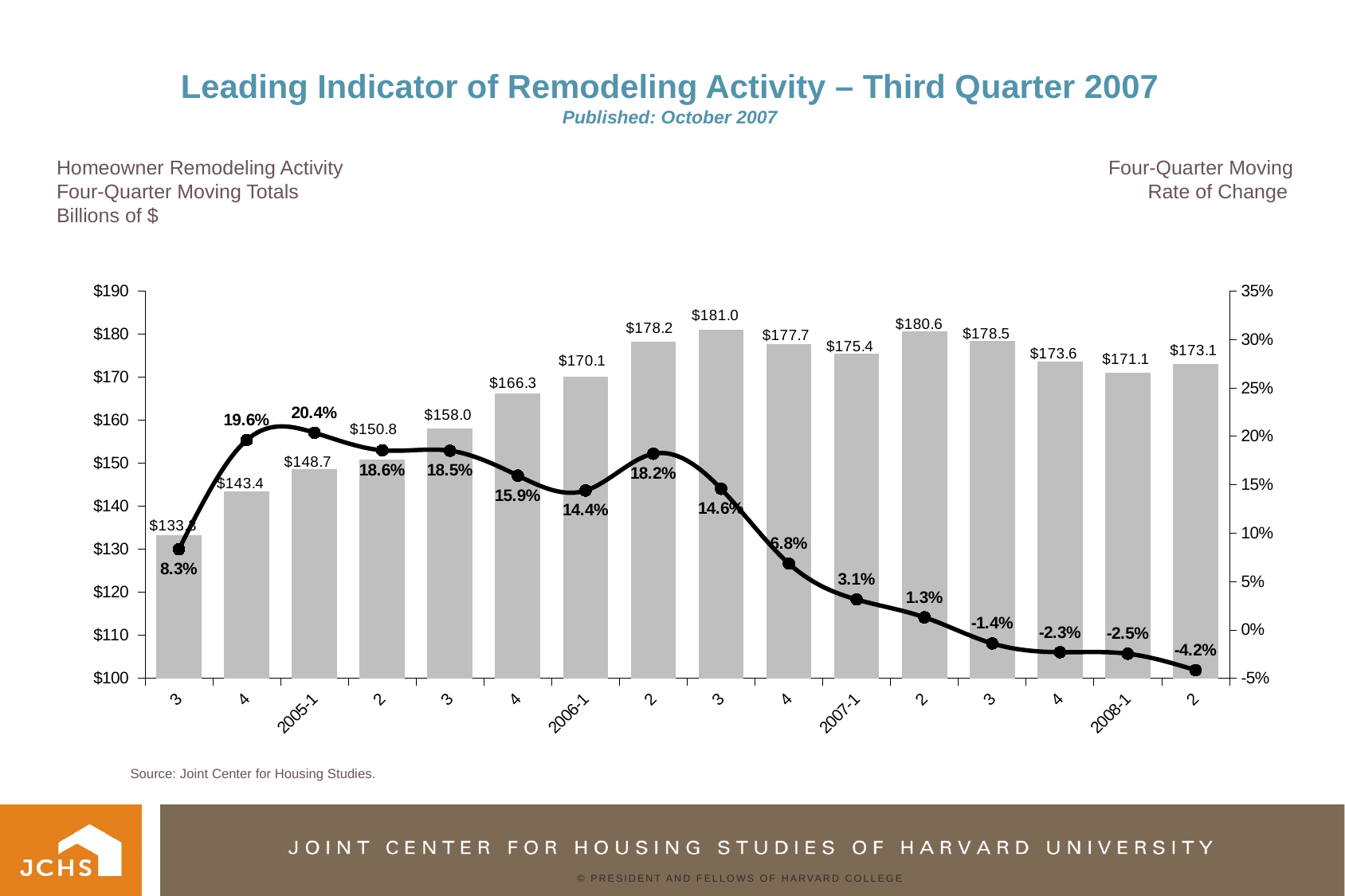
How many quarters are shown on the x axis of the chart? 16 What is the four-quarter moving total of homeowner remodeling activity for 2006-1? $170.1 Which quarter has the highest four-quarter moving total of homeowner remodeling activity? Third quarter of 2006 ($181.0) How much higher is the four-quarter moving total for the second quarter of 2007 than for 2007-1? $5.2 What kind of chart is shown on the slide? Bar chart with a line overlay Does the four-quarter moving rate of change rise or fall from the third quarter of 2006 to the second quarter of 2008? fall Which quarter has the lowest four-quarter moving rate of change? Second quarter of 2008 (-4.2%) What is the four-quarter moving rate of change for 2005-1? 20.4% Is the four-quarter moving rate of change for the fourth quarter of 2006 greater or less than 10%? less In what units are the four-quarter moving totals on the left axis expressed? Billions of $ What is the four-quarter moving rate of change for the third quarter of 2007 (the bar labeled 3 after 2007-1)? -1.4% Which is larger, the four-quarter moving total for 2008-1 or for the second quarter of 2008? Second quarter of 2008 ($173.1)